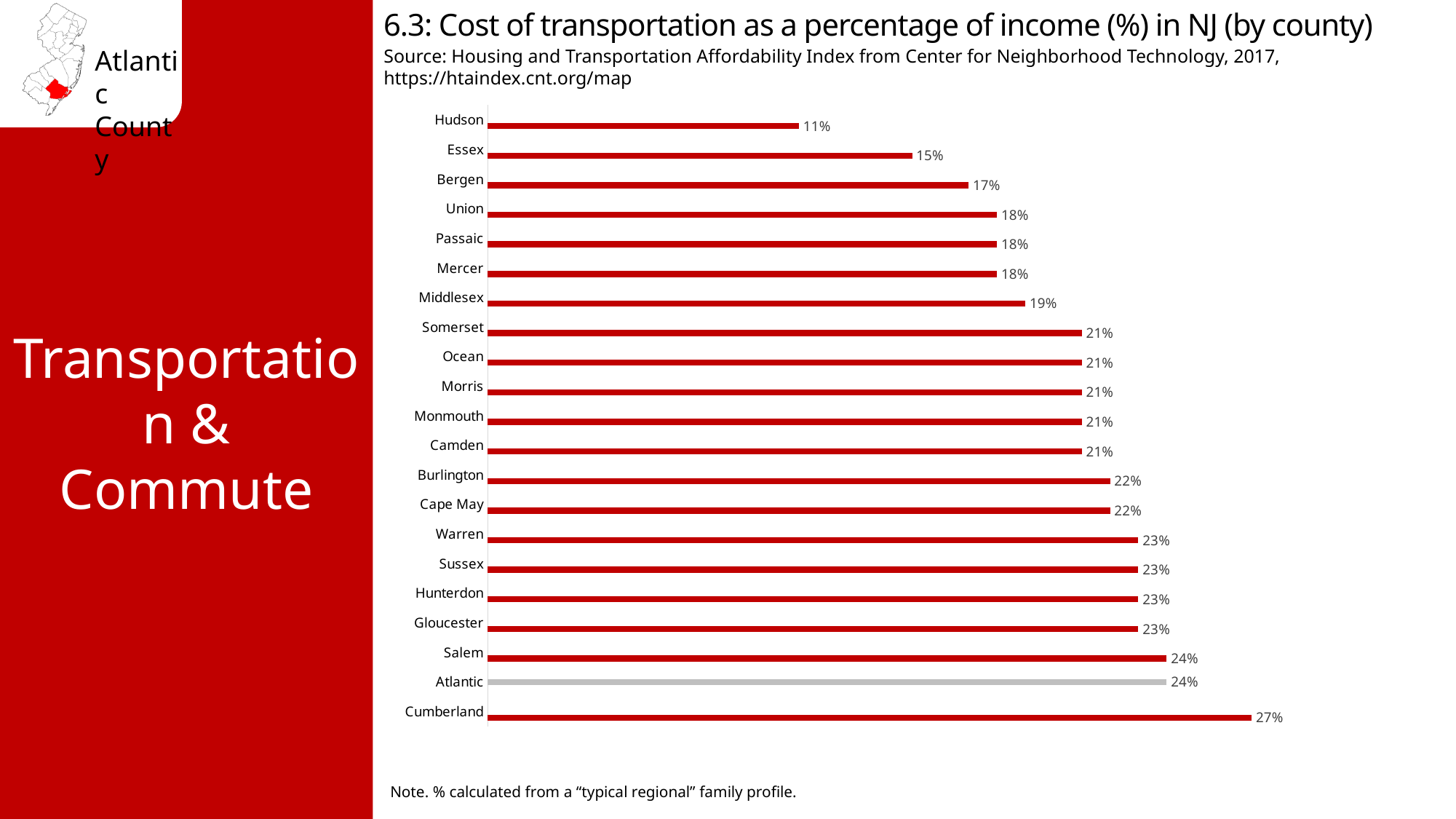
Which has a higher value, Cumberland or Salem? Cumberland Which county's bar is shown in grey instead of red? Atlantic What is the difference between the values for Atlantic and Essex? 9% What kind of chart is shown on the slide? Bar chart What is the value shown for Hudson County? 11% What is the cost of transportation as a percentage of income for Atlantic County? 24% What is the difference between the values for Cumberland and Hudson? 16% How many counties are shown in the chart? 21 Which has a higher value, Bergen or Burlington? Burlington Which county has the lowest cost of transportation as a percentage of income? Hudson Which county has the highest cost of transportation as a percentage of income? Cumberland What is the value shown for Middlesex County? 19%